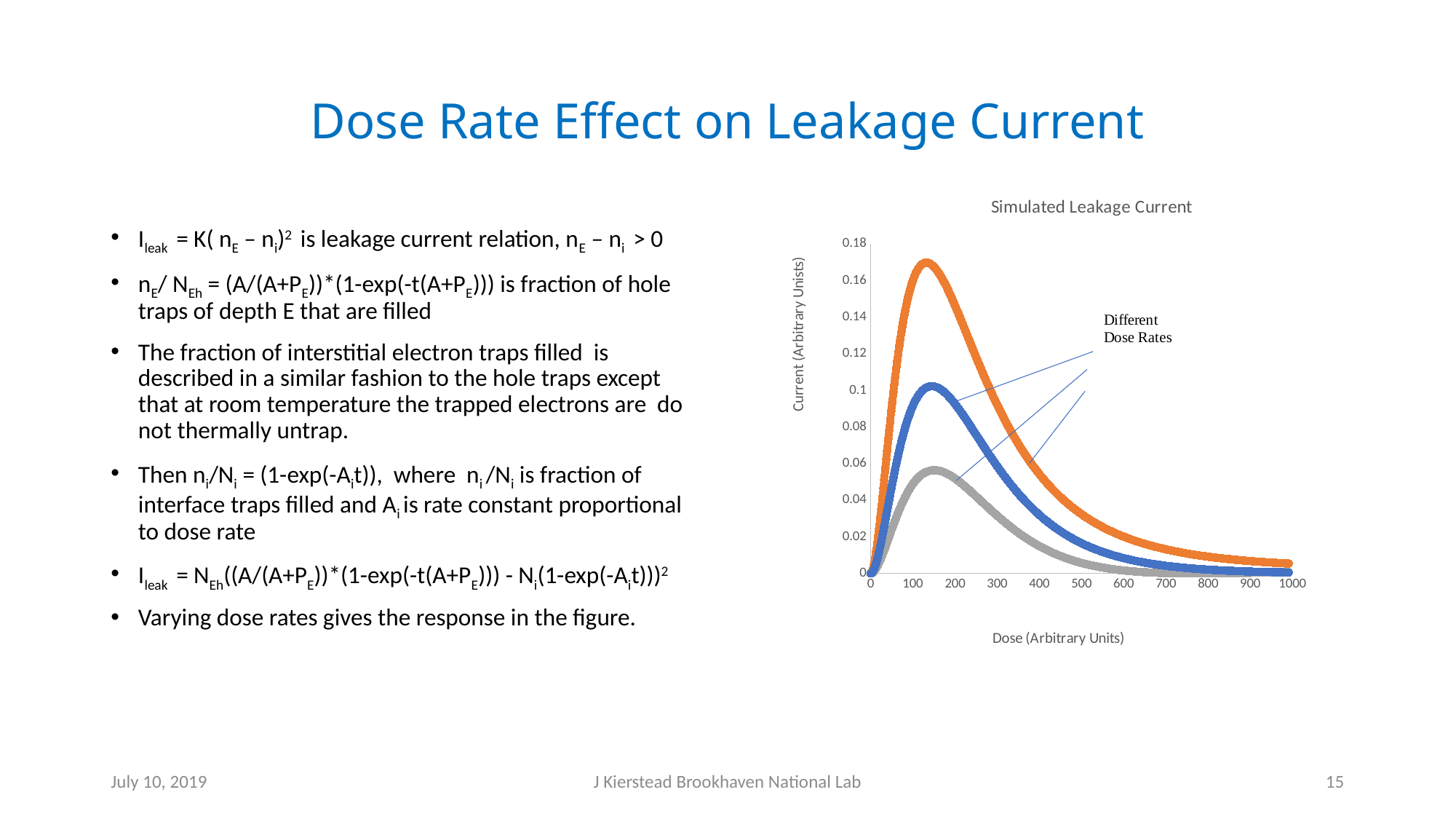
What is the highest tick value shown on the x axis? 1000 How many curves are plotted on the chart? 3 Is the peak value of the gray curve greater or less than 0.06? less Is the peak value of the orange curve greater or less than 0.16? greater Which curve has the lowest peak current: orange, blue or gray? gray Which curve reaches the highest peak current: orange, blue or gray? orange Do the curves rise or fall along the x axis between a dose of 200 and 1000? fall Is the peak value of the blue curve greater or less than 0.08? greater Which curve has the larger peak current, the blue curve or the gray curve? blue What kind of chart is shown on the slide? line chart What is the title of the chart? Simulated Leakage Current What is the label of the x axis of the chart? Dose (Arbitrary Units)